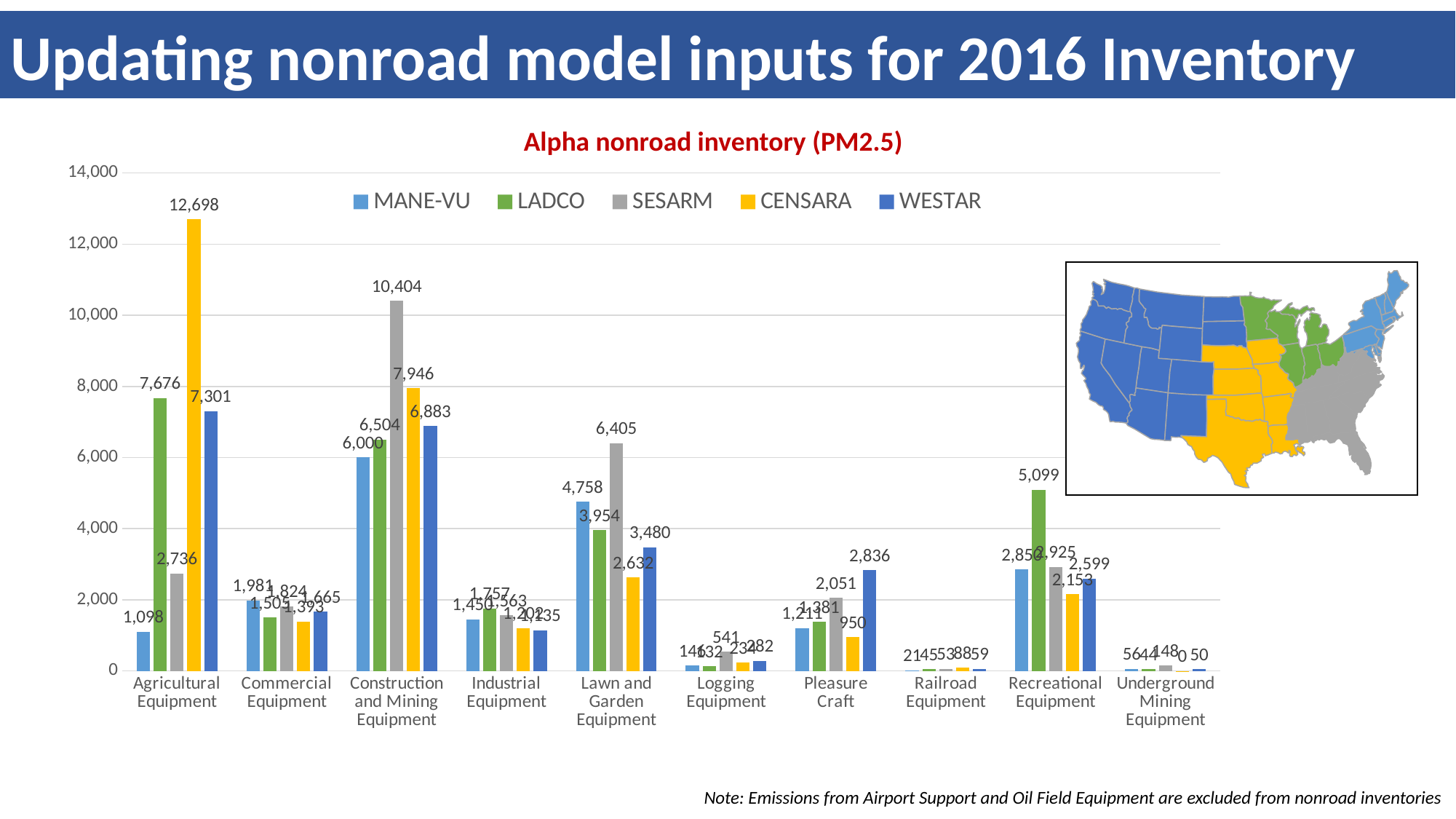
Is the SESARM value for Logging Equipment greater or less than 2,000? less What type of chart is shown on the slide? bar chart Which series has the highest value for Lawn and Garden Equipment? SESARM What is the LADCO value for Recreational Equipment? 5,099 What is the difference between the CENSARA and LADCO values for Agricultural Equipment? 5,022 Which is larger for Construction and Mining Equipment, the CENSARA value or the WESTAR value? CENSARA How many series does the legend list? 5 What is the WESTAR value for Pleasure Craft? 2,836 Which series has the lowest value for Agricultural Equipment? MANE-VU How many equipment categories are shown on the x axis? 10 What is the CENSARA value for Agricultural Equipment? 12,698 What is the SESARM value for Construction and Mining Equipment? 10,404